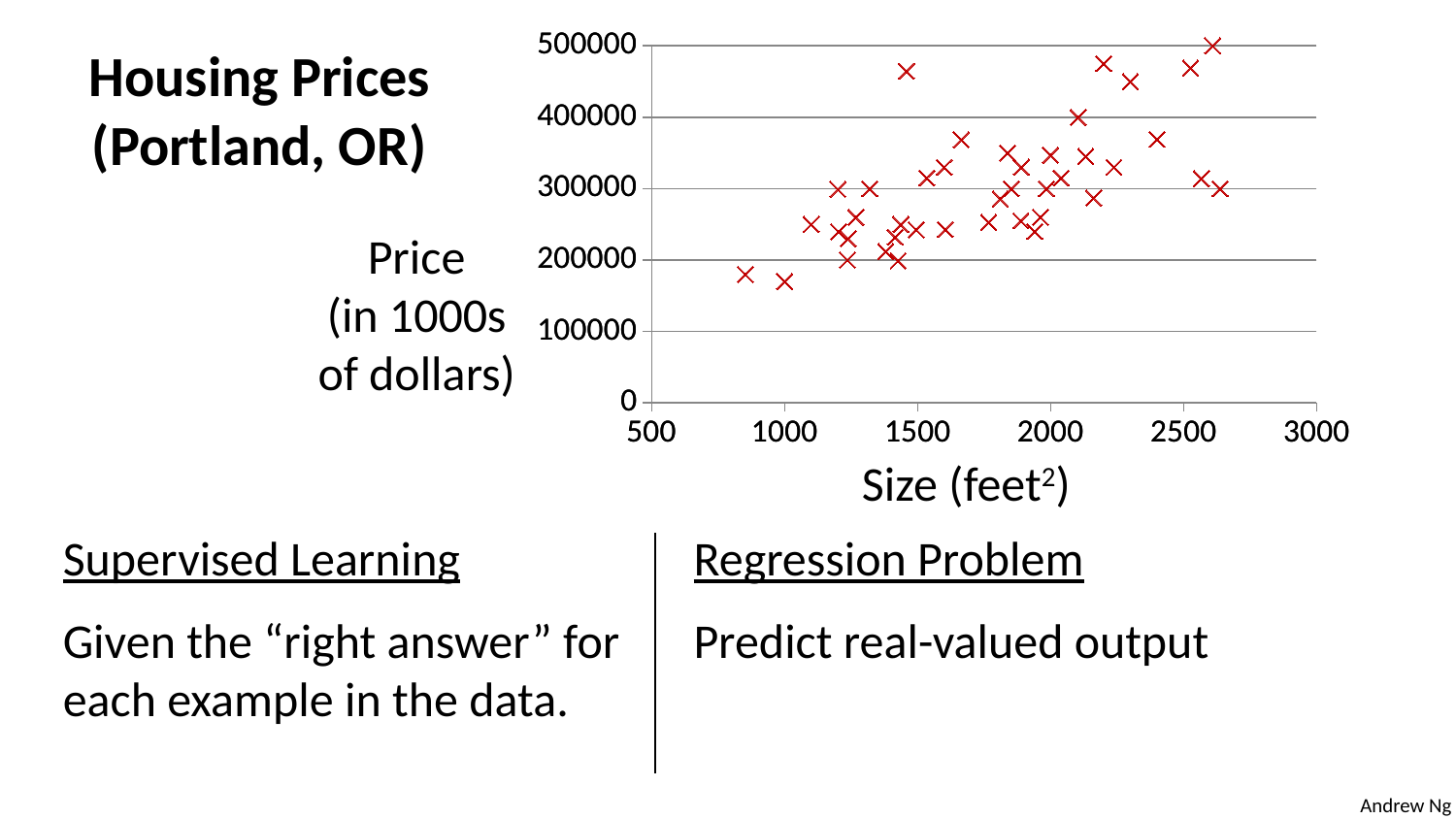
What is the label of the x axis of the chart? Size (feet²) Is the price of the leftmost point (smallest house) greater or less than 200000? less What kind of chart is shown on the slide? scatter plot Is the price of the rightmost point (largest house) greater or less than 400000? less Is the price of the leftmost point (smallest house) greater or less than 100000? greater What is the title of the chart? Housing Prices (Portland, OR) Do the plotted prices generally rise or fall as house size increases along the x axis? rise